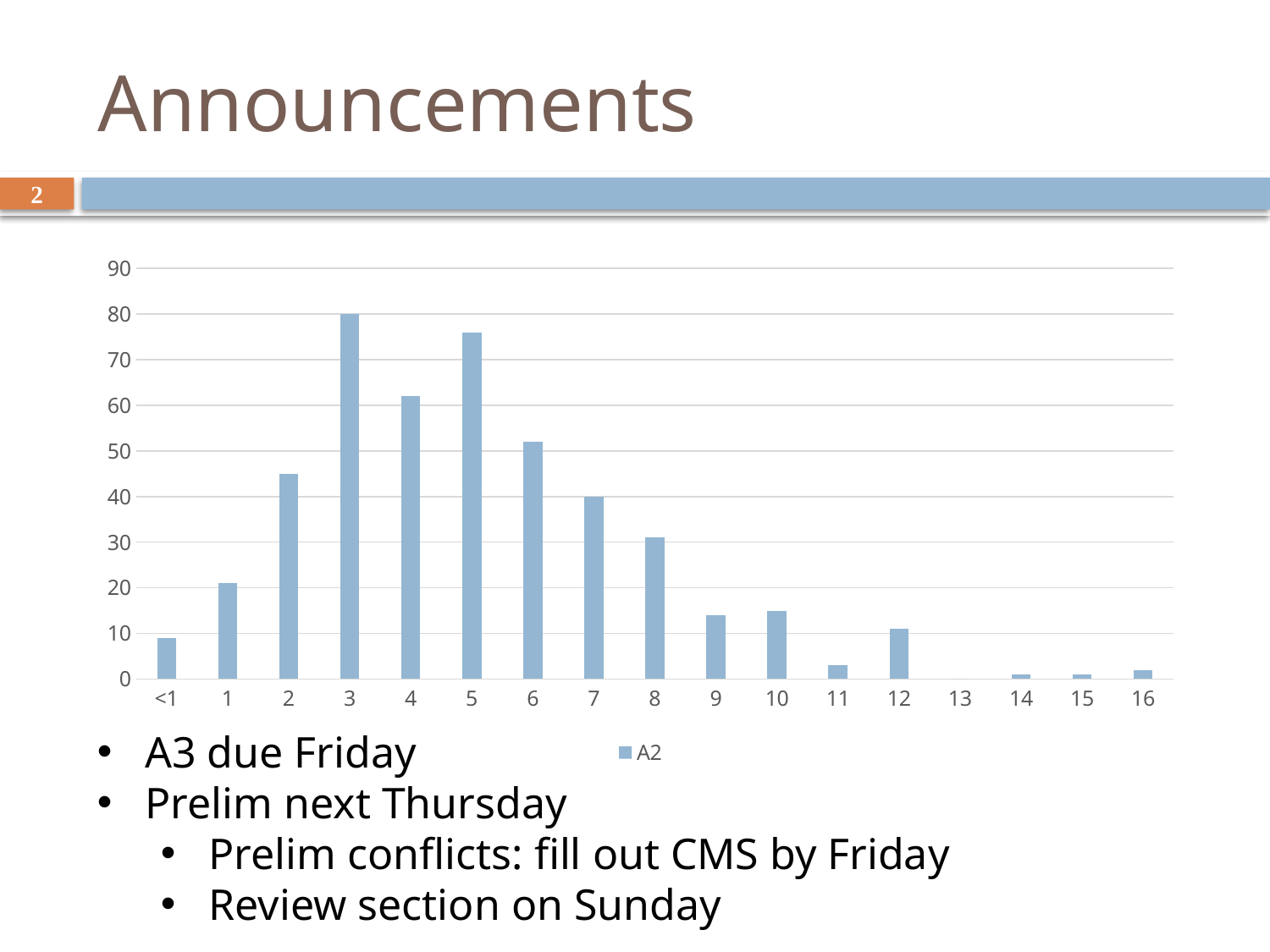
Which is larger, the value for category 4 or the value for category 5? 5 How many categories are shown on the x axis of the chart? 17 Is the value for category 5 greater or less than 70? greater Is the value for category 8 greater or less than 40? less Which category has the highest value in the chart? 3 What kind of chart is shown on the slide? bar chart What is the value for category 7? 40 Is the value for category 9 greater or less than 20? less What is the value for category 3? 80 Which category has the lowest value in the chart? 13 How many series does the legend list, and what is it called? 1, A2 Which is larger, the value for category 2 or the value for category 6? 6